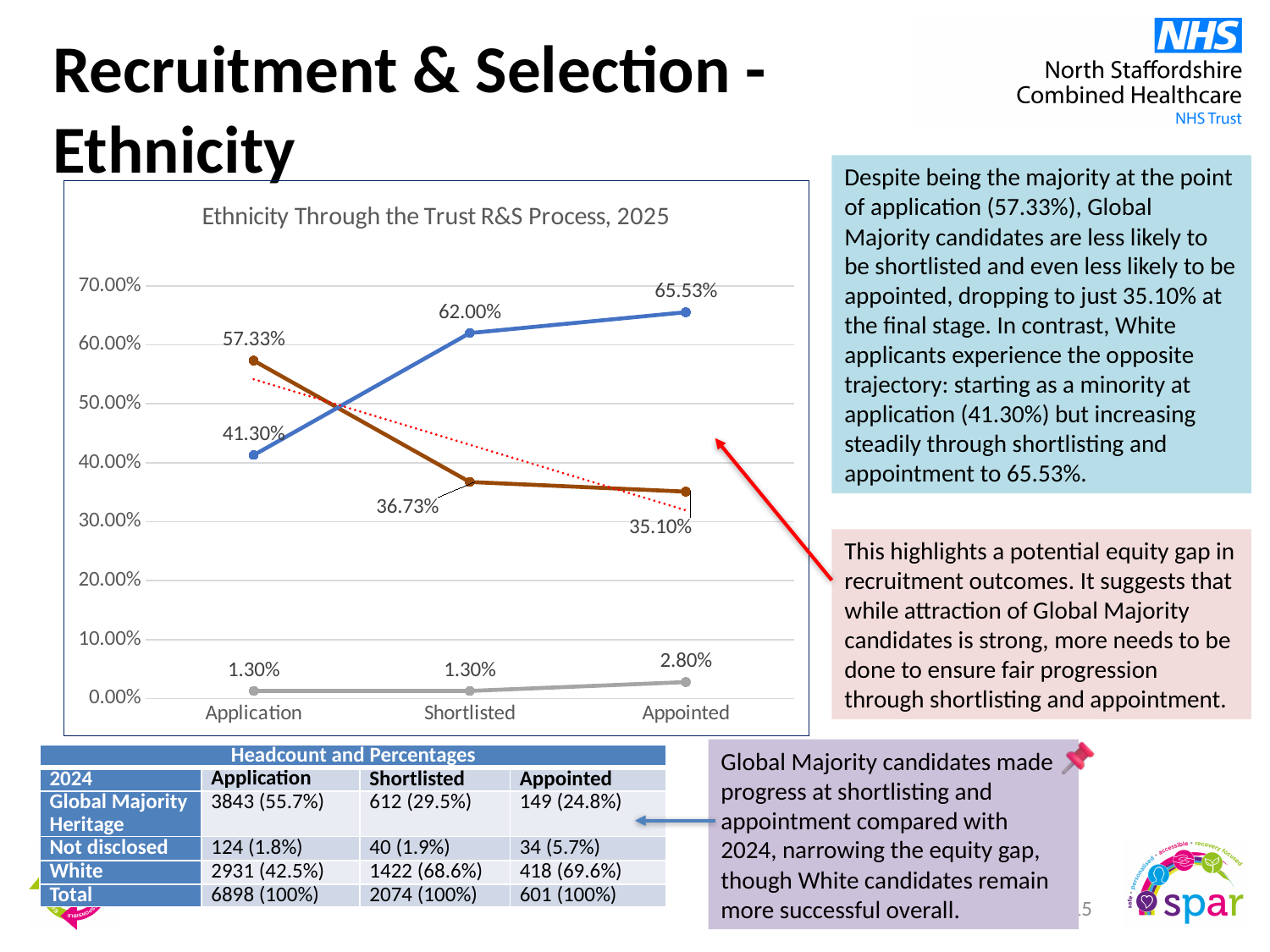
Does the blue line rise or fall from Application to Appointed? rise What is the value of the blue line (White applicants) at the Shortlisted stage? 62.00% How many stages are shown along the x axis of the chart? 3 What is the value of the grey line at the Appointed stage? 2.80% What is the value of the brown line (Global Majority candidates) at the Appointed stage? 35.10% At the Shortlisted stage, which is larger: the blue line or the brown line? the blue line What is the difference between the blue line and the brown line at the Appointed stage? 30.43% What is the difference between the brown line and the blue line at the Application stage? 16.03% What kind of chart is shown on the slide? line chart Does the brown line rise or fall from Application to Appointed? fall What is the title of the chart? Ethnicity Through the Trust R&S Process, 2025 Which line has the highest value at the Application stage? the brown line (57.33%)